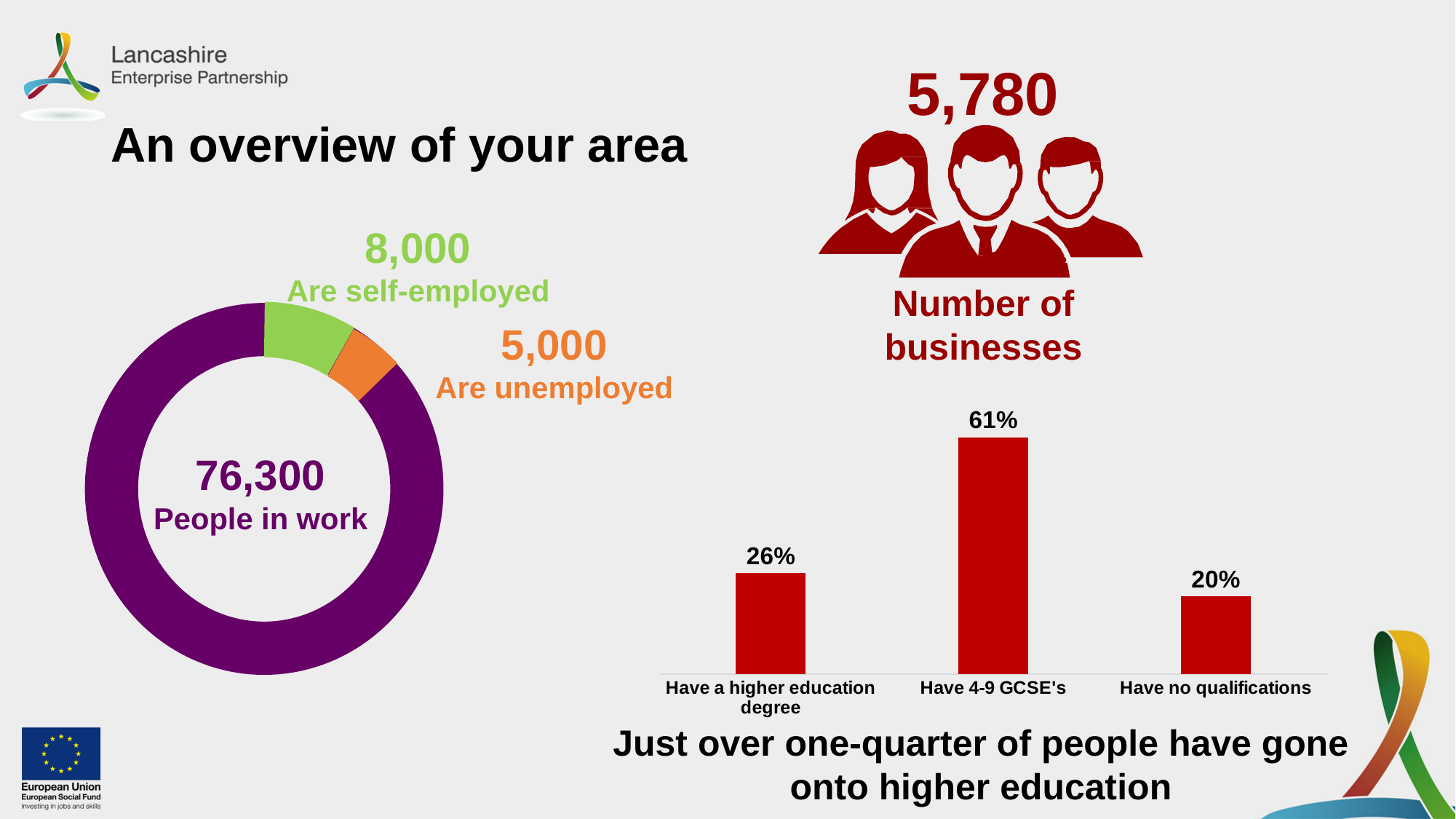
In the donut chart on the left, how many people are in work? 76,300 In the donut chart on the left, what is the difference between the number self-employed and the number unemployed? 3,000 In the donut chart on the left, which is larger: the number self-employed or the number unemployed? Self-employed In the bar chart on the right, how many categories are shown? 3 In the bar chart on the right, what percentage of people have a higher education degree? 26% In the bar chart on the right, which category has the lowest value? Have no qualifications In the bar chart on the right, what percentage of people have 4-9 GCSE's? 61% What kind of chart is the chart on the right of the slide? Bar chart In the bar chart on the right, which category has the highest value? Have 4-9 GCSE's In the bar chart on the right, what is the difference between the percentage with 4-9 GCSE's and the percentage with a higher education degree? 35% In the bar chart on the right, what percentage of people have no qualifications? 20% In the donut chart on the left, how many people are self-employed? 8,000